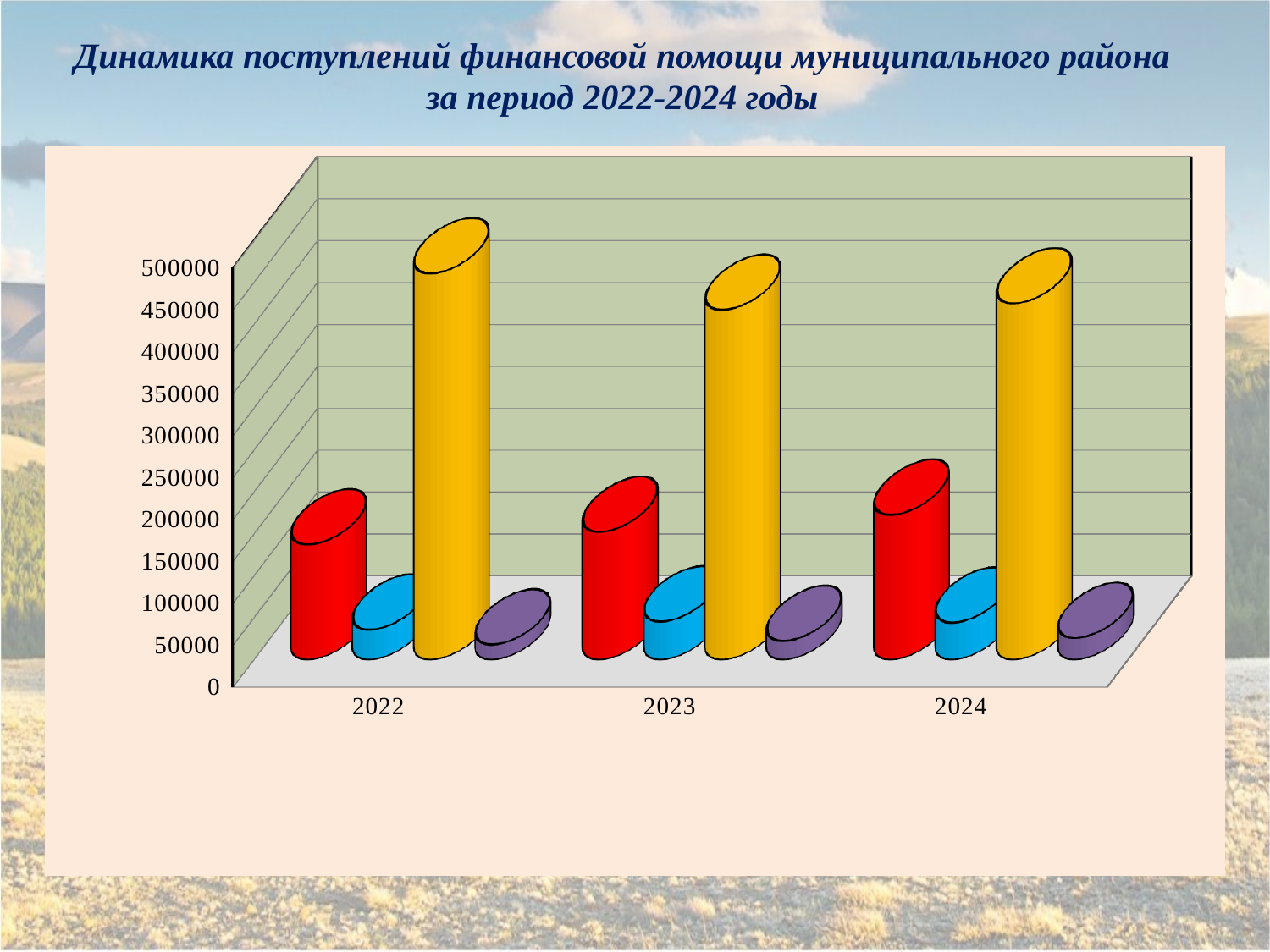
Which coloured bar is the lowest in 2024? Purple Do the red bars rise or fall from 2022 to 2024? Rise Is the value of the purple bar for 2022 greater or less than 150000? less Is the value of the blue bar for 2024 greater or less than 200000? less Which coloured bar is the highest in 2023? Yellow How many years (categories) are shown on the x axis of the chart? 3 Is the value of the yellow bar for 2022 greater or less than 300000? greater Does the chart include a legend identifying the coloured series? No In 2022, which is larger: the yellow bar or the red bar? Yellow What kind of chart is shown on the slide? Bar chart What is the title of the slide's chart? Динамика поступлений финансовой помощи муниципального района за период 2022-2024 годы